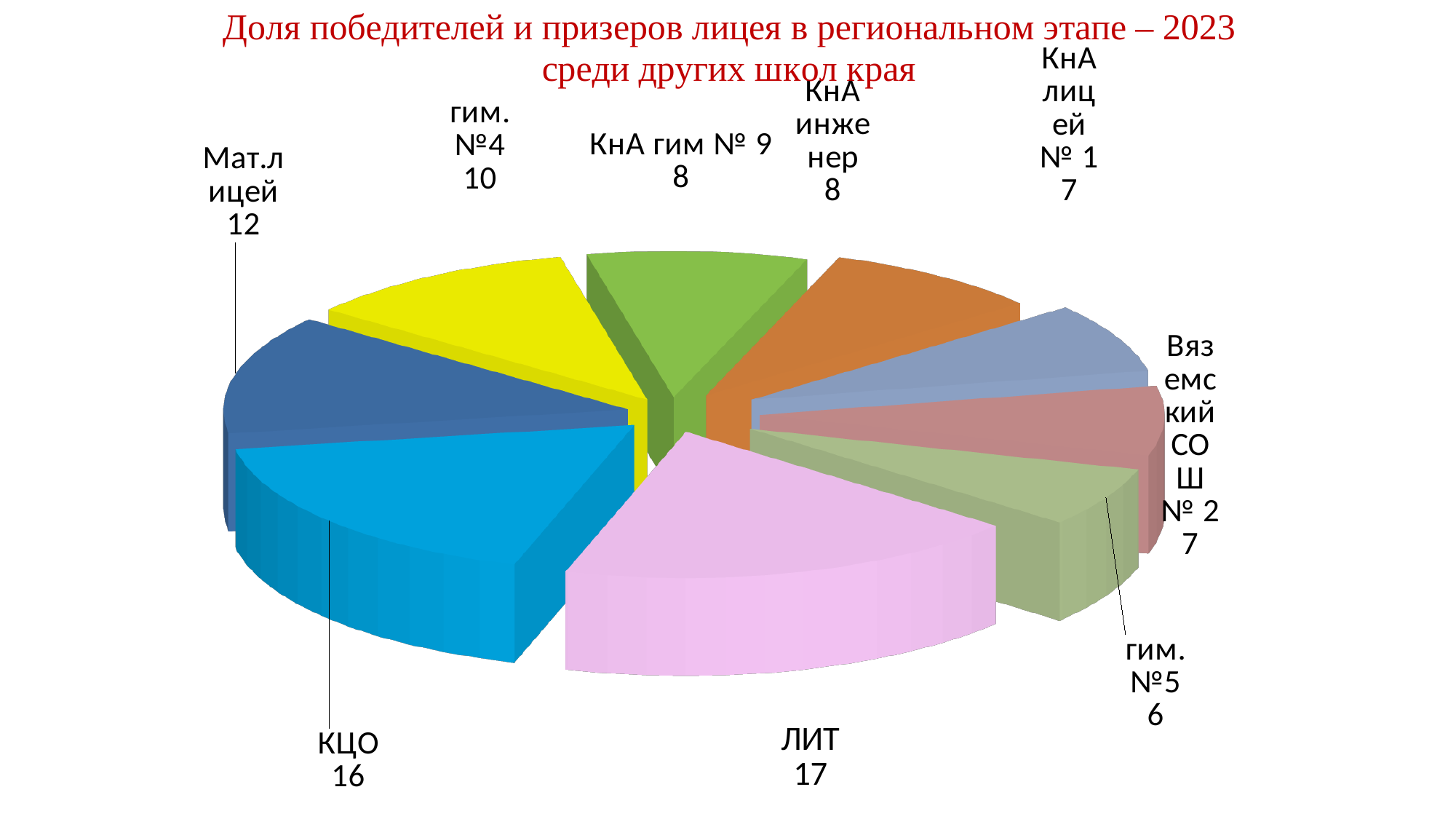
What is the value for Мат.лицей? 12 What kind of chart is shown on the slide? pie chart What is the value for гим. №4? 10 Which category has the highest value? ЛИТ What is the difference between the values for ЛИТ and КЦО? 1 Which is larger, the value for Мат.лицей or the value for гим. №4? Мат.лицей What is the value for Вяземский СОШ № 2? 7 What is the title of the chart? Доля победителей и призеров лицея в региональном этапе – 2023 среди других школ края How many slices does the pie chart have? 9 What is the value for ЛИТ? 17 What is the value for КЦО? 16 Which category has the lowest value? гим. №5